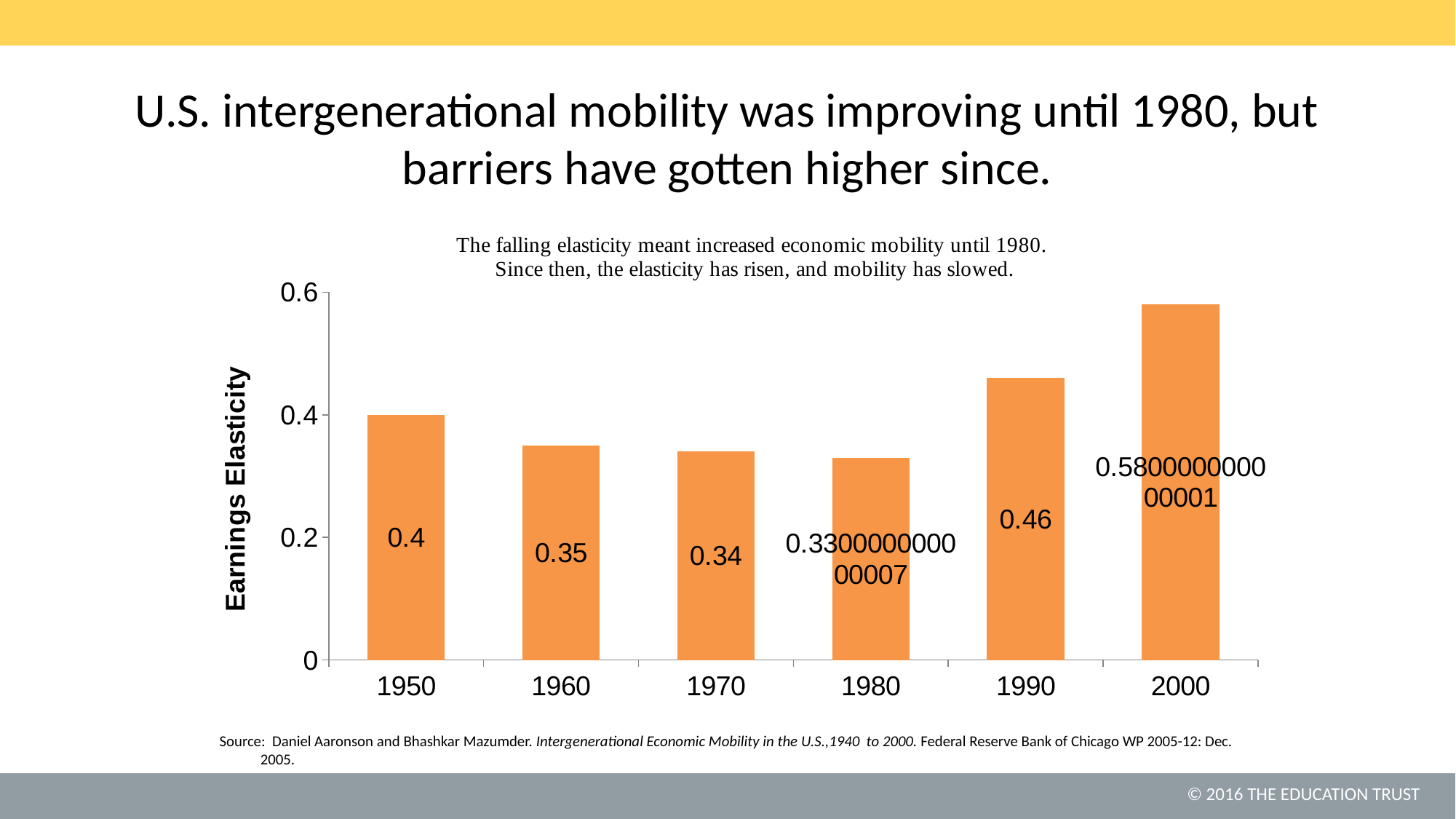
How many years are shown on the x axis of the chart? 6 Is the value for 2000 greater or less than 0.4? greater What is the difference between the earnings elasticity in 1990 and in 1970? 0.12 Which year has the lowest earnings elasticity? 1980 What is the earnings elasticity value for 1960? 0.35 What is the earnings elasticity value for 1950? 0.4 Which year has the highest earnings elasticity? 2000 What is the title of the y axis of the chart? Earnings Elasticity What is the difference between the earnings elasticity in 1950 and in 1960? 0.05 What kind of chart is shown on the slide? bar chart What is the earnings elasticity value for 1990? 0.46 Which year has a larger earnings elasticity, 1950 or 1990? 1990